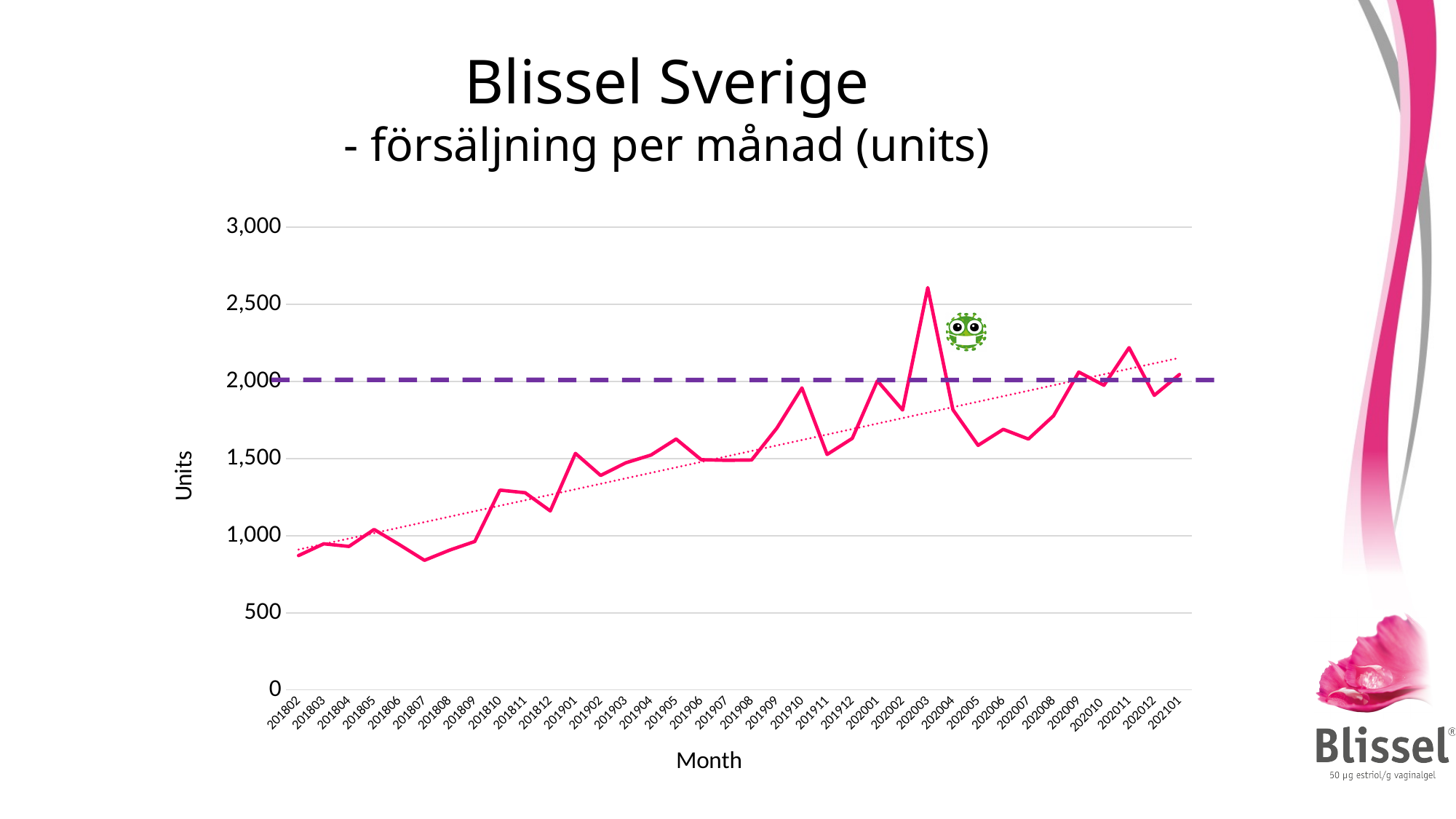
Is the value for 202005 greater or less than 2,000? less What kind of chart is shown on the slide? line chart Which is larger, the value for 202005 or the value for 202009? 202009 What is the label on the y axis? Units Is the value for 202003 greater or less than 2,500? greater Is the value for 202011 greater or less than 2,000? greater Which is larger, the value for 201802 or the value for 201810? 201810 Do the values generally rise or fall from 201802 to 202101? rise Which month has the highest value? 202003 How many months are plotted along the x axis? 36